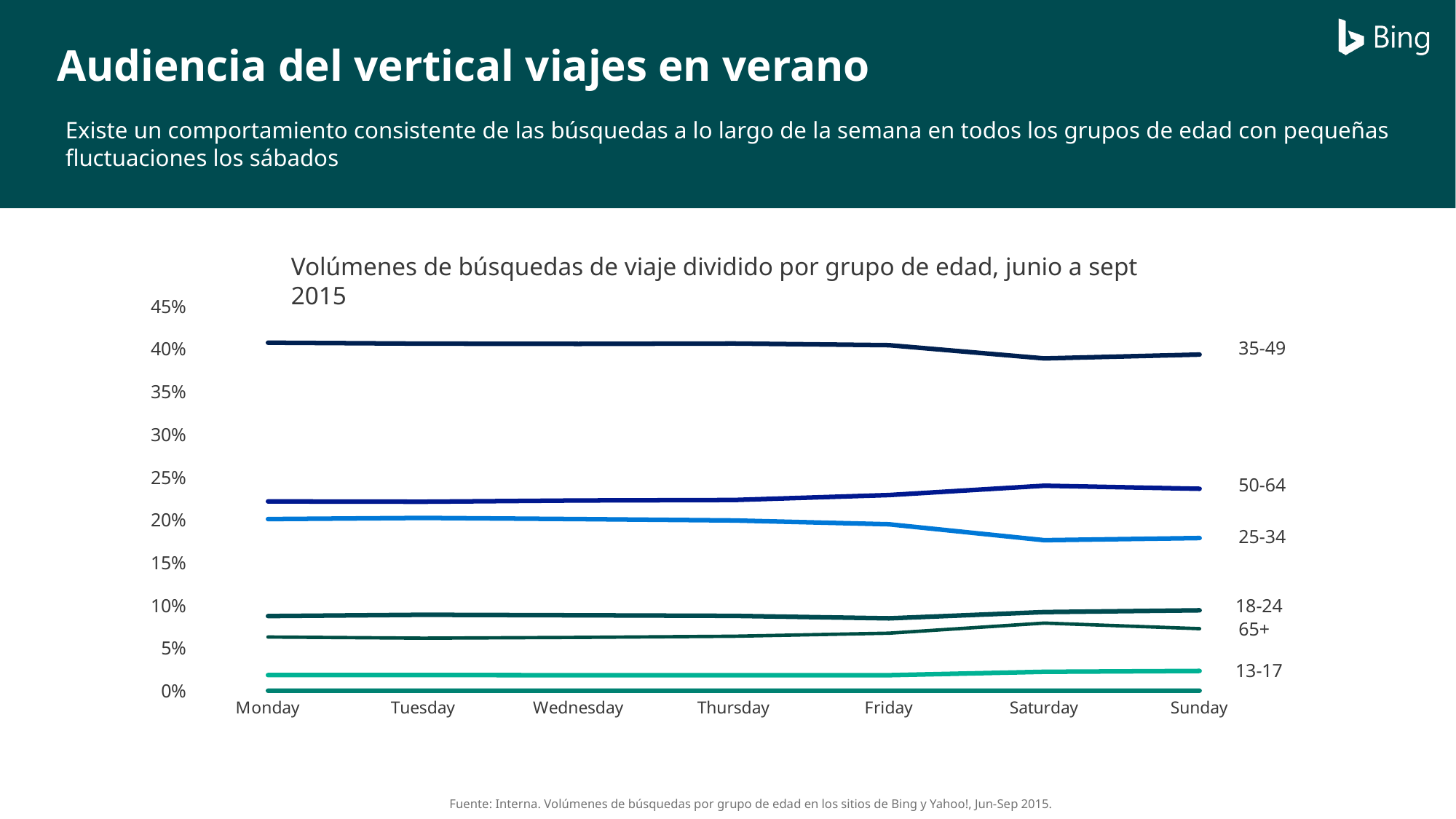
What kind of chart is shown on the slide? line chart Is the value for the 13-17 group on Sunday greater or less than 5%? less On Saturday, which is larger: the value for the 50-64 group or the 25-34 group? 50-64 What is the title of the chart? Volúmenes de búsquedas de viaje dividido por grupo de edad, junio a sept 2015 How many days of the week are shown on the x axis of the chart? 7 Which age group has the highest search volume share across the week? 35-49 Which labelled age group has the lowest search volume share across the week? 13-17 Is the value for the 25-34 group on Saturday greater or less than 20%? less Does the line for the 35-49 group rise or fall from Friday to Saturday? fall How many age-group labels are shown at the right end of the lines in the chart? 6 Is the value for the 35-49 group on Monday greater or less than 35%? greater